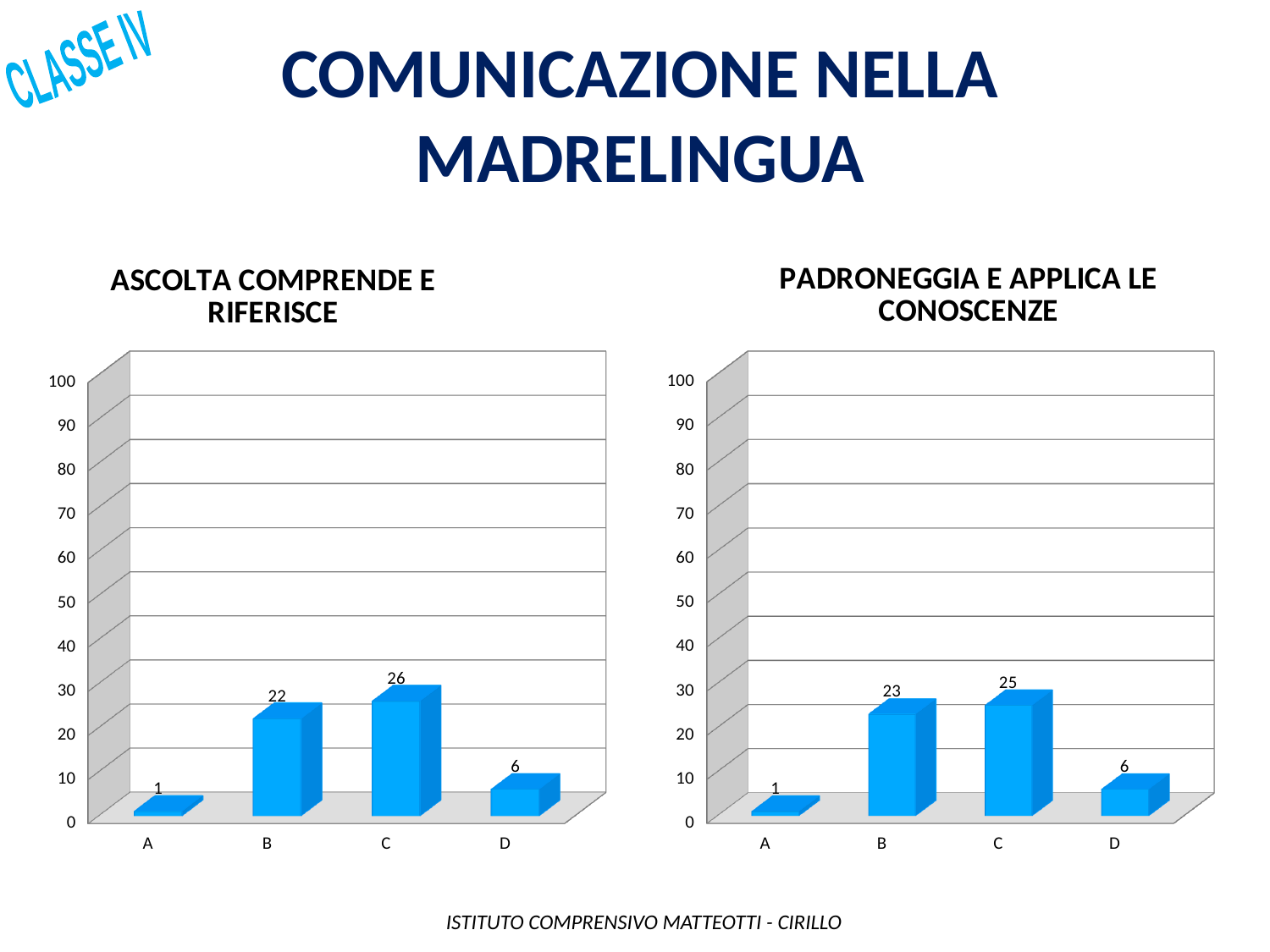
In the 'ASCOLTA COMPRENDE E RIFERISCE' chart, what is the value for category C? 26 In the 'PADRONEGGIA E APPLICA LE CONOSCENZE' chart, which category has the lowest value? A In the 'ASCOLTA COMPRENDE E RIFERISCE' chart, what is the difference between the values for C and B? 4 How many categories are shown in the 'PADRONEGGIA E APPLICA LE CONOSCENZE' chart? 4 In the 'ASCOLTA COMPRENDE E RIFERISCE' chart, is the value for B greater or less than 30? less What kind of chart is the 'ASCOLTA COMPRENDE E RIFERISCE' chart? bar chart In the 'ASCOLTA COMPRENDE E RIFERISCE' chart, which category has the highest value? C In the 'ASCOLTA COMPRENDE E RIFERISCE' chart, what is the value for category B? 22 In the 'PADRONEGGIA E APPLICA LE CONOSCENZE' chart, what is the value for category D? 6 In the 'PADRONEGGIA E APPLICA LE CONOSCENZE' chart, what is the difference between the values for C and D? 19 In the 'PADRONEGGIA E APPLICA LE CONOSCENZE' chart, what is the value for category B? 23 In the 'PADRONEGGIA E APPLICA LE CONOSCENZE' chart, which is larger, the value for B or the value for C? C